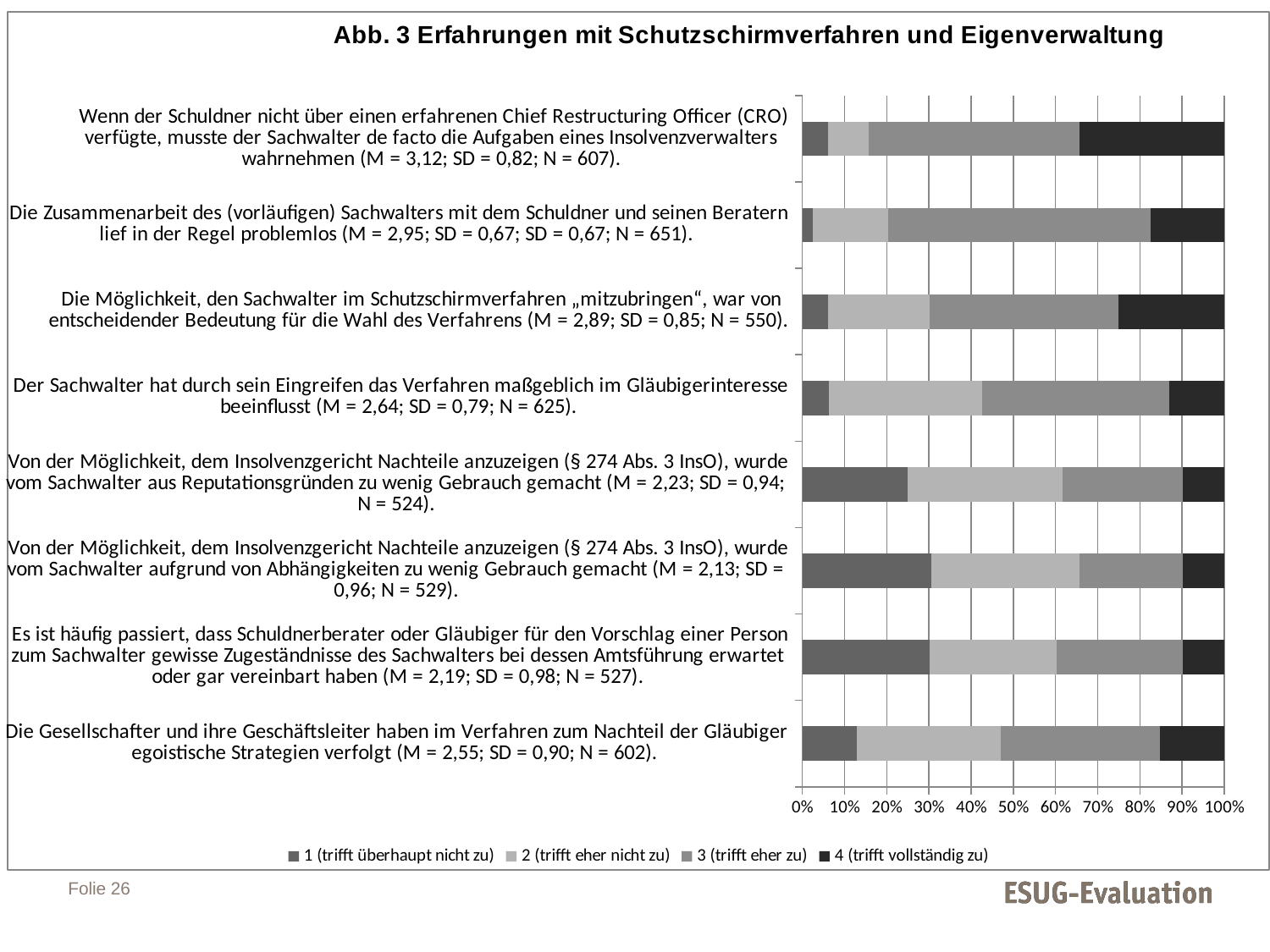
Which has the larger share of "4 (trifft vollständig zu)": the statement about the Chief Restructuring Officer (CRO) or the statement about the Zusammenarbeit des (vorläufigen) Sachwalters? The statement about the Chief Restructuring Officer (CRO) How many series does the legend list? 4 Which legend entry is shown in the darkest (black) colour? 4 (trifft vollständig zu) What kind of chart is shown on the slide? Stacked bar chart Which statement has the smallest share of "1 (trifft überhaupt nicht zu)"? Die Zusammenarbeit des (vorläufigen) Sachwalters mit dem Schuldner und seinen Beratern lief in der Regel problemlos Which statement has the largest share of "4 (trifft vollständig zu)"? Wenn der Schuldner nicht über einen erfahrenen Chief Restructuring Officer (CRO) verfügte, musste der Sachwalter de facto die Aufgaben eines Insolvenzverwalters wahrnehmen How many statements (categories) are plotted in the chart? 8 Is the share of "1 (trifft überhaupt nicht zu)" for the statement about the Zusammenarbeit des (vorläufigen) Sachwalters greater or less than 10%? less Which has the larger share of "1 (trifft überhaupt nicht zu)": the statement about Nachteile anzuzeigen aus Reputationsgründen or the statement about the Zusammenarbeit des (vorläufigen) Sachwalters? The statement about Nachteile anzuzeigen aus Reputationsgründen Is the share of "1 (trifft überhaupt nicht zu)" for the statement about Nachteile anzuzeigen aufgrund von Abhängigkeiten greater or less than 20%? greater What is the title of the chart? Abb. 3 Erfahrungen mit Schutzschirmverfahren und Eigenverwaltung Is the share of "4 (trifft vollständig zu)" for the statement about the Chief Restructuring Officer (CRO) greater or less than 20%? greater